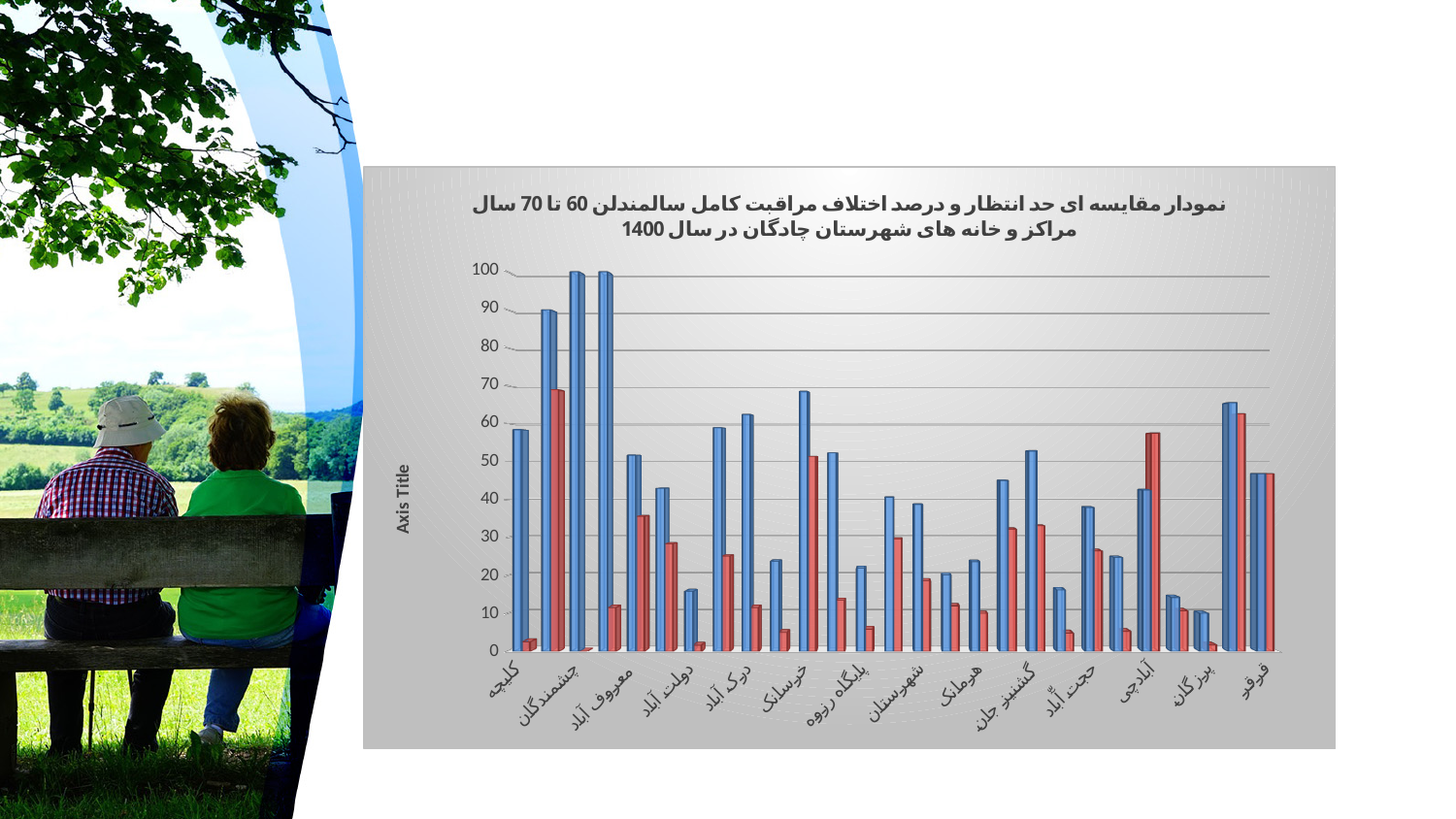
What kind of chart is shown on the slide? bar chart What year is mentioned in the chart title? 1400 What is the highest value shown on the vertical axis of the chart? 100 What is the label on the vertical axis of the chart? Axis Title For کلیچه, which bar is taller, the blue one or the red one? blue Does any red bar reach 100 on the vertical axis? No Is the blue bar for کلیچه greater or less than 50? greater Which colour of bar reaches the top value of 100 on the axis? blue How many different bar colours are used in the chart? 2 Is the red bar for کلیچه greater or less than 10? less